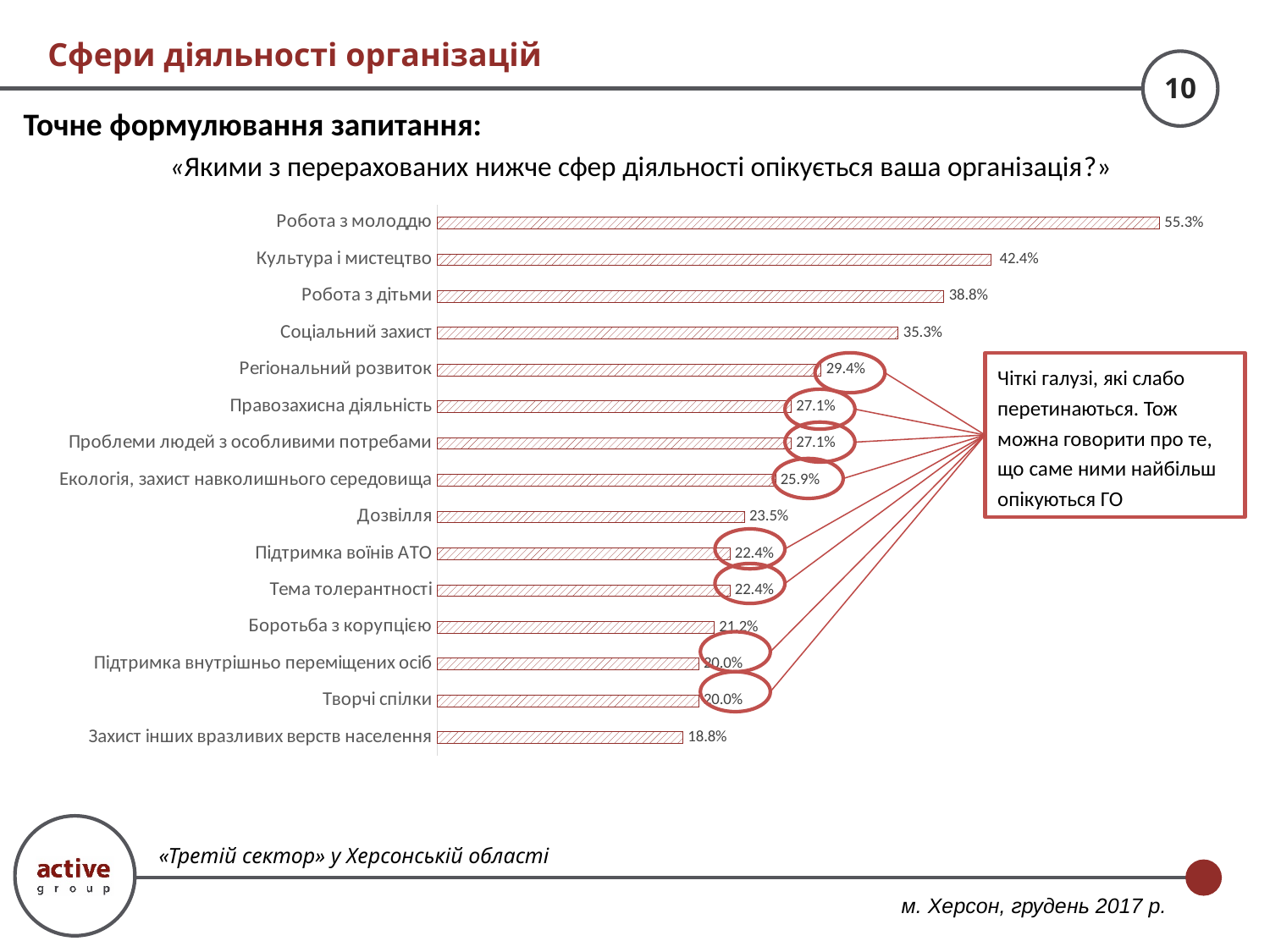
Which category has the lowest value? Захист інших вразливих верств населення Do the values rise or fall going from the top bar to the bottom bar? Fall Which is larger: the value for "Регіональний розвиток" or the value for "Дозвілля"? Регіональний розвиток What is the value for "Соціальний захист"? 35.3% What is the value for "Екологія, захист навколишнього середовища"? 25.9% What is the value for "Боротьба з корупцією"? 21.2% How many categories are shown in the chart? 15 What is the value for "Робота з молоддю"? 55.3% Which category has the highest value? Робота з молоддю What type of chart is shown on the slide? Bar chart What is the difference between the values for "Робота з дітьми" and "Дозвілля"? 15.3% What is the difference between the values for "Робота з молоддю" and "Культура і мистецтво"? 12.9%